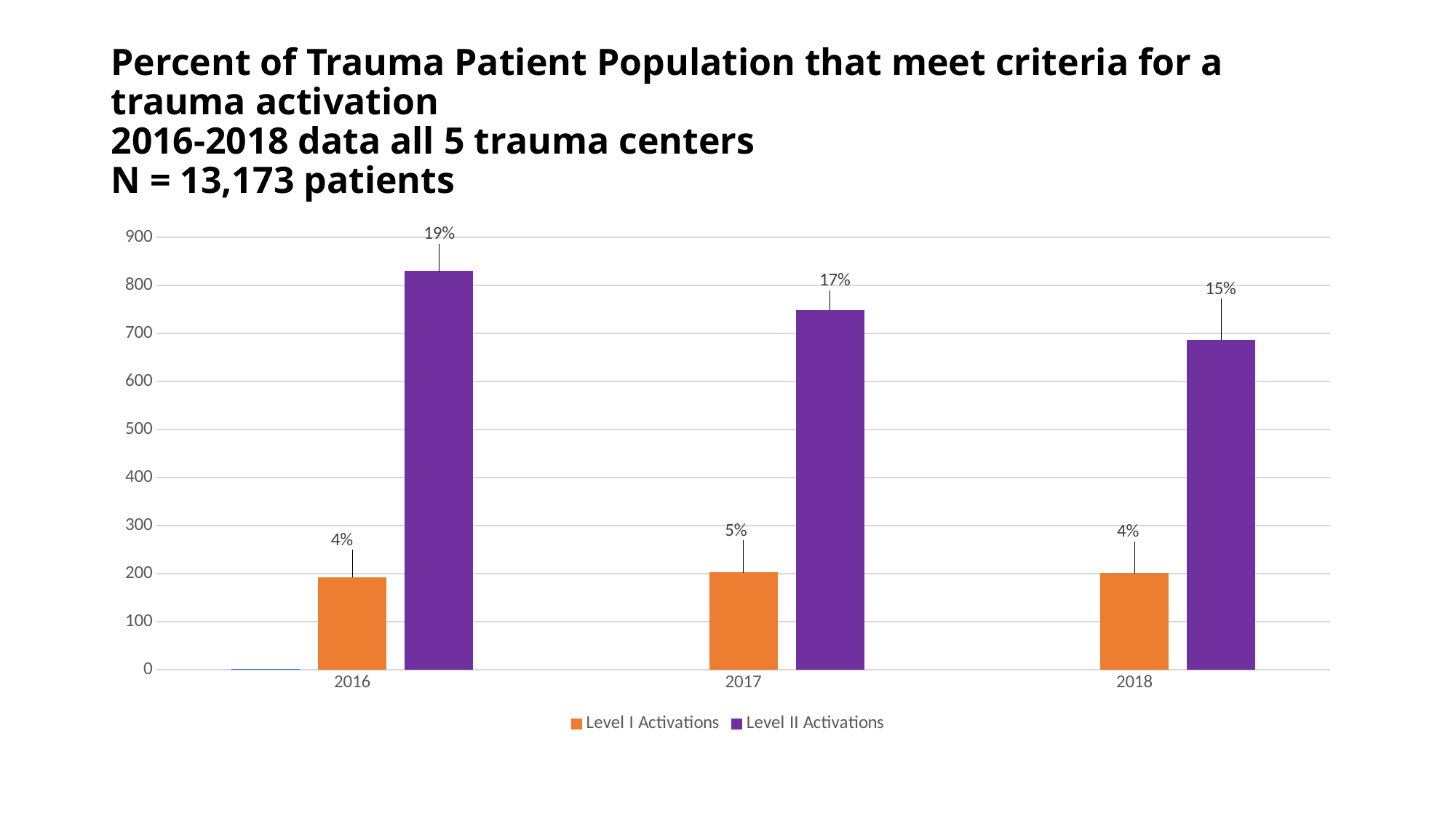
What percentage label is shown on the Level II Activations bar for 2018? 15% What percentage label is shown on the Level I Activations bar for 2018? 4% Do the Level II Activations bars rise or fall from 2016 to 2018? fall Which year has the lowest Level II Activations bar? 2018 What percentage label is shown on the Level II Activations bar for 2016? 19% What percentage label is shown on the Level I Activations bar for 2017? 5% Is the Level II Activations bar for 2018 greater or less than 700? less Is the Level II Activations bar for 2016 greater or less than 800? greater What kind of chart is shown on the slide? bar chart How many series does the legend list? 2 Which year has the highest Level II Activations bar? 2016